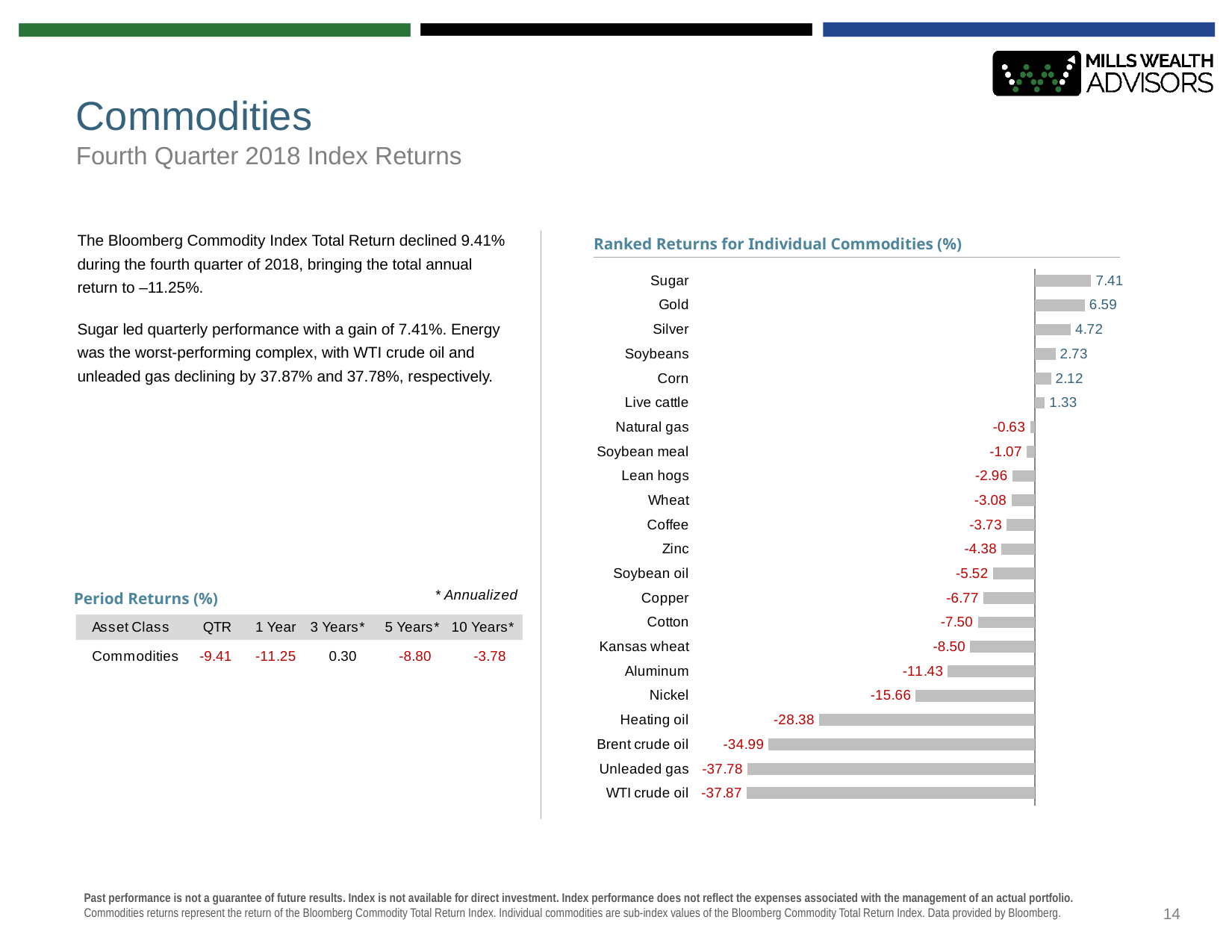
What is the value for Nickel in the Ranked Returns for Individual Commodities chart? -15.66 Which commodity has the highest return in the Ranked Returns for Individual Commodities chart? Sugar What kind of chart is the Ranked Returns for Individual Commodities chart? Bar chart What is the value for Copper in the Ranked Returns for Individual Commodities chart? -6.77 What is the difference between the values for Gold and Silver in the Ranked Returns for Individual Commodities chart? 1.87 Which commodity has the lowest return in the Ranked Returns for Individual Commodities chart? WTI crude oil How many commodities are shown in the Ranked Returns for Individual Commodities chart? 22 Which has the larger return in the Ranked Returns for Individual Commodities chart, Soybeans or Corn? Soybeans Which has the larger return in the Ranked Returns for Individual Commodities chart, Aluminum or Kansas wheat? Kansas wheat What is the value for Sugar in the Ranked Returns for Individual Commodities chart? 7.41 How many commodities in the Ranked Returns for Individual Commodities chart have a positive return? 6 What is the difference between the values for Heating oil and Brent crude oil in the Ranked Returns for Individual Commodities chart? 6.61